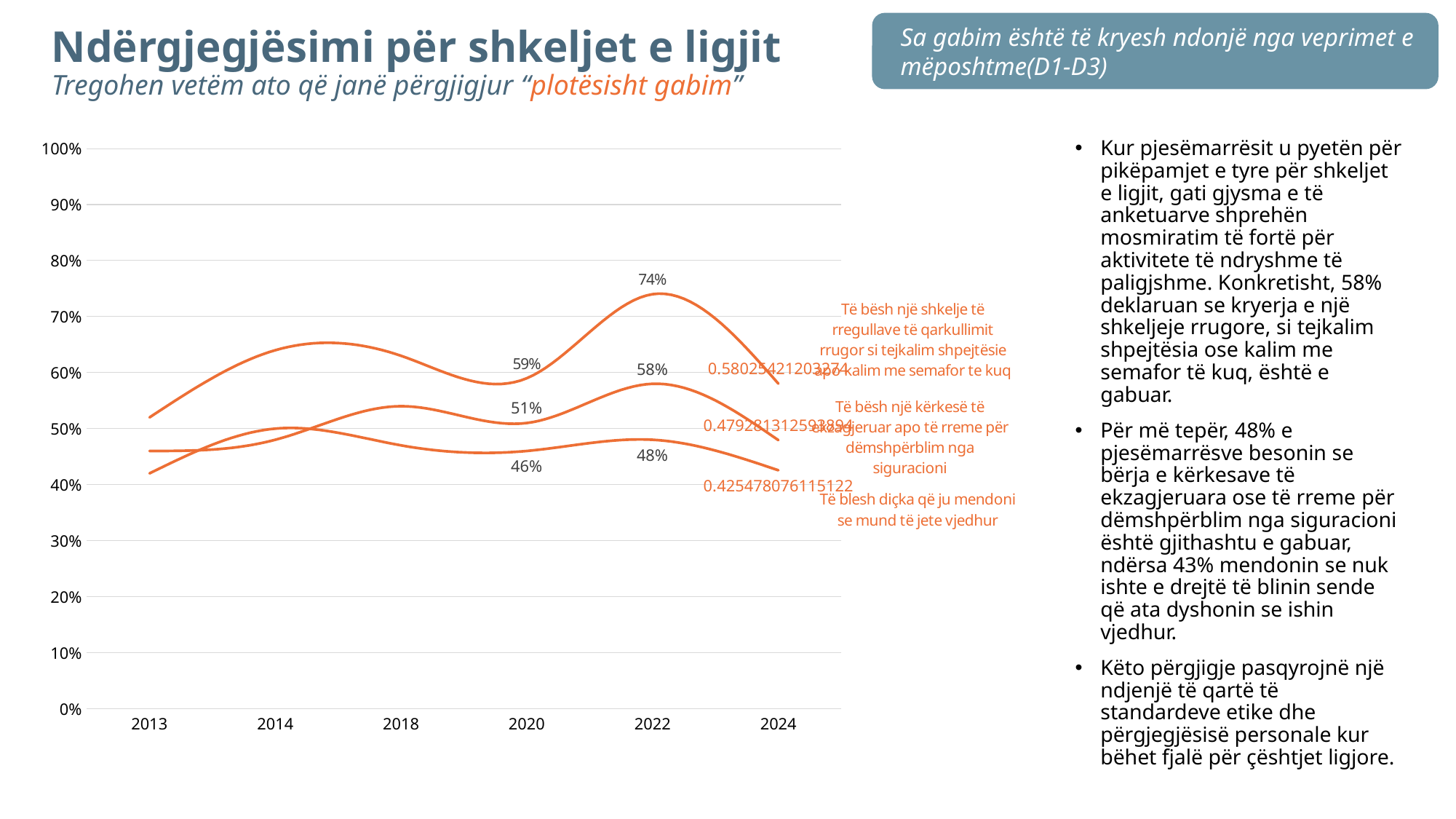
What is the value in 2022 for the series about buying something you think might be stolen (Të blesh diçka që ju mendoni se mund të jetë vjedhur)? 48% In which year does the traffic violation series (Të bësh një shkelje të rregullave të qarkullimit rrugor) reach its highest value? 2022 What is the data label shown for 2024 on the traffic violation series (Të bësh një shkelje të rregullave të qarkullimit rrugor)? 0.58025421203374 How many years are shown on the x axis of the chart? 6 Is the 2013 value for the false insurance claim series (Të bësh një kërkesë të ekzagjeruar apo të rreme) greater or less than 50%? less What kind of chart is shown on the slide? line chart What is the value in 2020 for the series about making an exaggerated or false insurance claim (Të bësh një kërkesë të ekzagjeruar apo të rreme për dëmshpërblim nga siguracioni)? 51% What is the value in 2022 for the series about committing a traffic violation such as speeding or running a red light (Të bësh një shkelje të rregullave të qarkullimit rrugor)? 74% Between 2022 and 2024, does the traffic violation series rise or fall? fall For the traffic violation series, which year has the larger value: 2020 or 2022? 2022 In 2020, what is the difference between the traffic violation series (59%) and the buying stolen goods series (46%)? 13 percentage points In 2022, what is the difference between the traffic violation series (74%) and the false insurance claim series (58%)? 16 percentage points